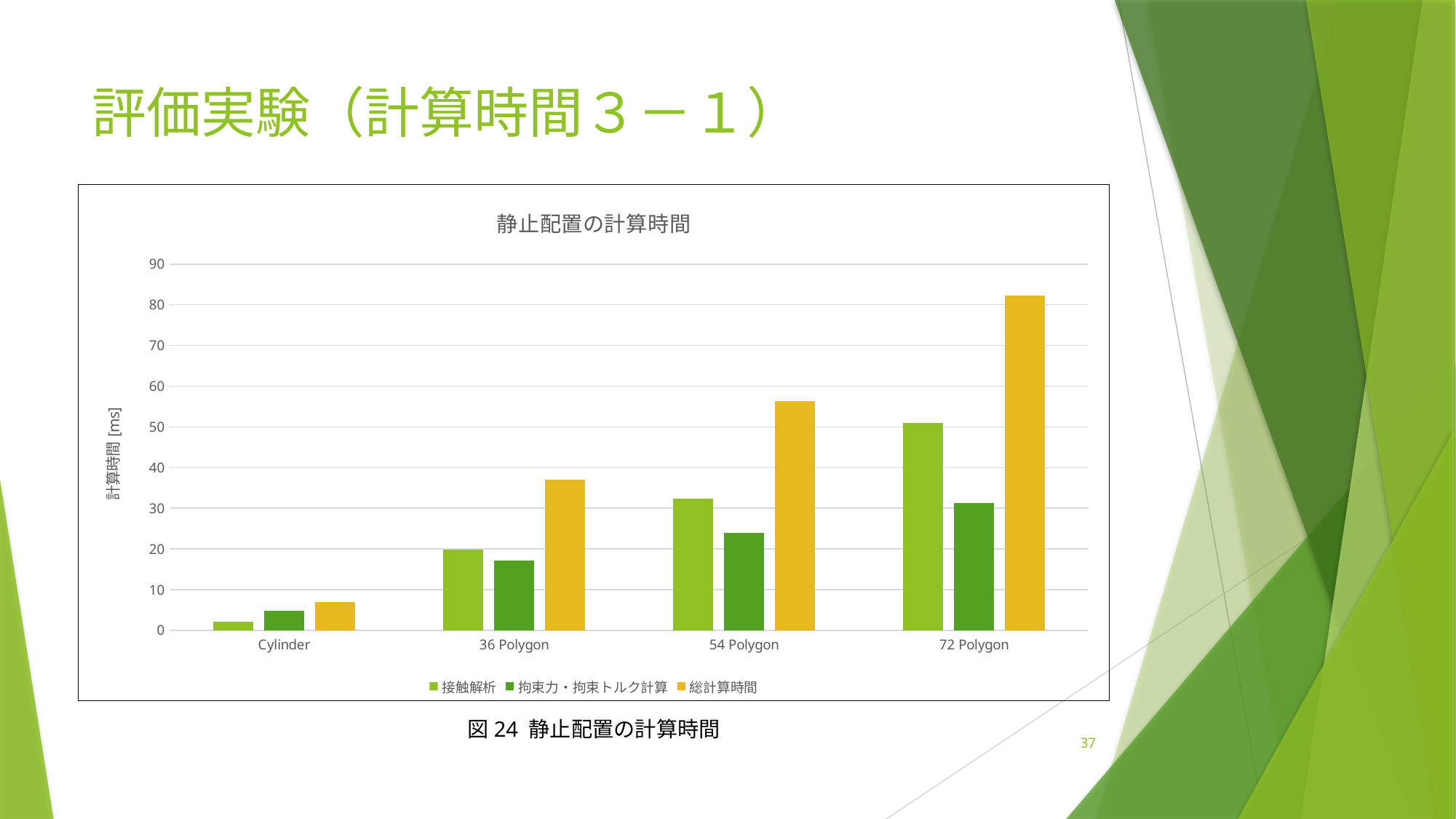
How many series does the chart legend list? 3 Which category has the lowest 総計算時間 value? Cylinder What is the label of the vertical axis? 計算時間 [ms] What is the title of the chart? 静止配置の計算時間 How many categories are shown on the x axis of the chart? 4 Is the 拘束力・拘束トルク計算 value for 36 Polygon greater or less than 20? less Which category has the highest 総計算時間 value? 72 Polygon Does the 総計算時間 value rise or fall from Cylinder to 72 Polygon along the x axis? rise What kind of chart is shown on the slide? Bar chart Is the 総計算時間 value for 54 Polygon greater or less than 50? greater For 54 Polygon, which is larger: 接触解析 or 拘束力・拘束トルク計算? 接触解析 Is the 接触解析 value for 72 Polygon greater or less than 40? greater